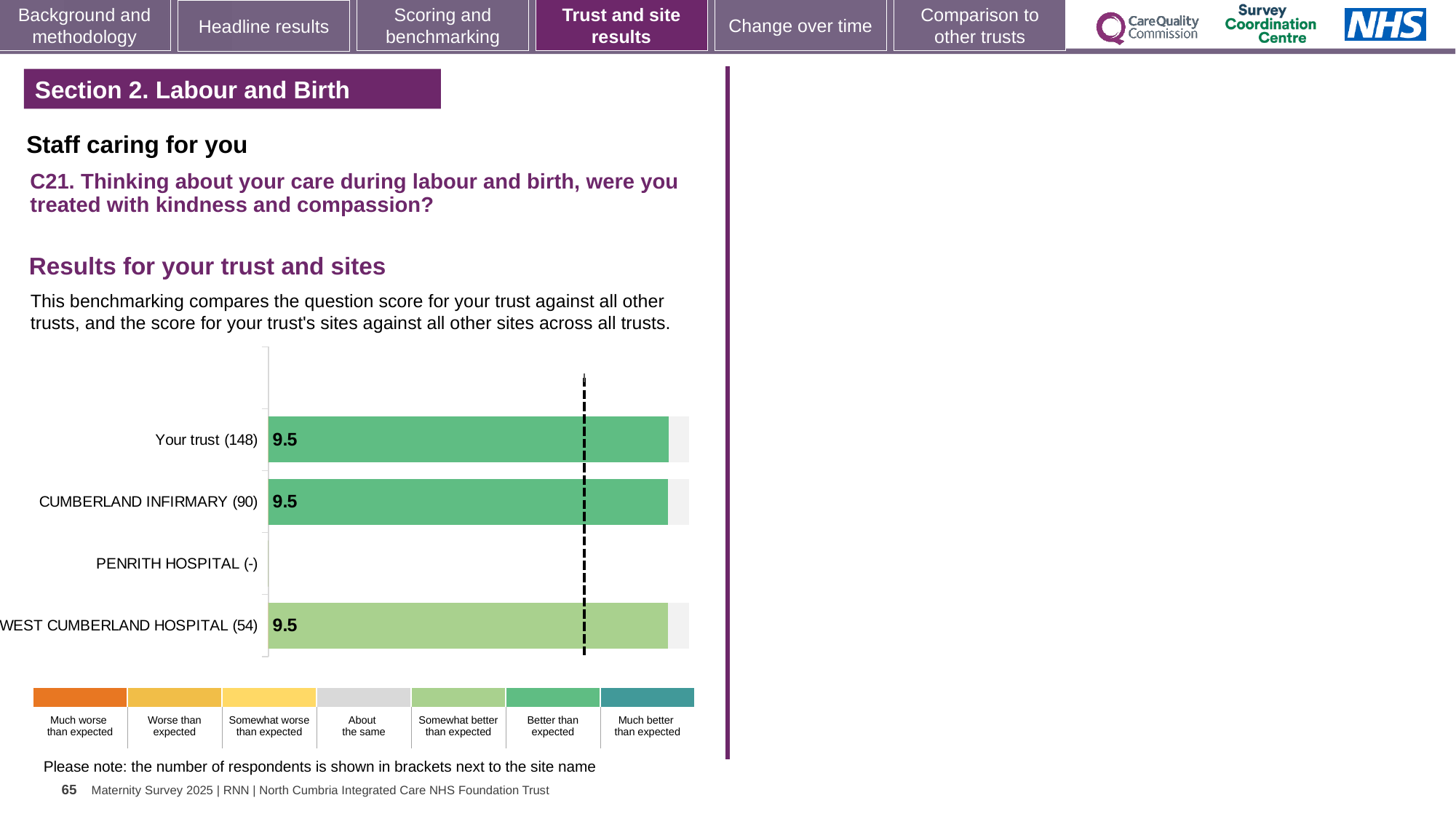
According to the colour legend, which benchmark category does the bar for WEST CUMBERLAND HOSPITAL fall into? Somewhat better than expected How many benchmark categories does the colour legend below the chart list? 7 How many respondents are shown in brackets for Your trust? 148 What is the difference between the score for Your trust and the score for CUMBERLAND INFIRMARY? 0.0 How many categories (rows) are listed on the chart's vertical axis? 4 What is the score for CUMBERLAND INFIRMARY? 9.5 Which site has no bar plotted on the chart? PENRITH HOSPITAL What kind of chart is shown on the slide? Bar chart What is the score for Your trust? 9.5 How many respondents are shown in brackets for WEST CUMBERLAND HOSPITAL? 54 What is the score for WEST CUMBERLAND HOSPITAL? 9.5 How many respondents are shown in brackets for CUMBERLAND INFIRMARY? 90